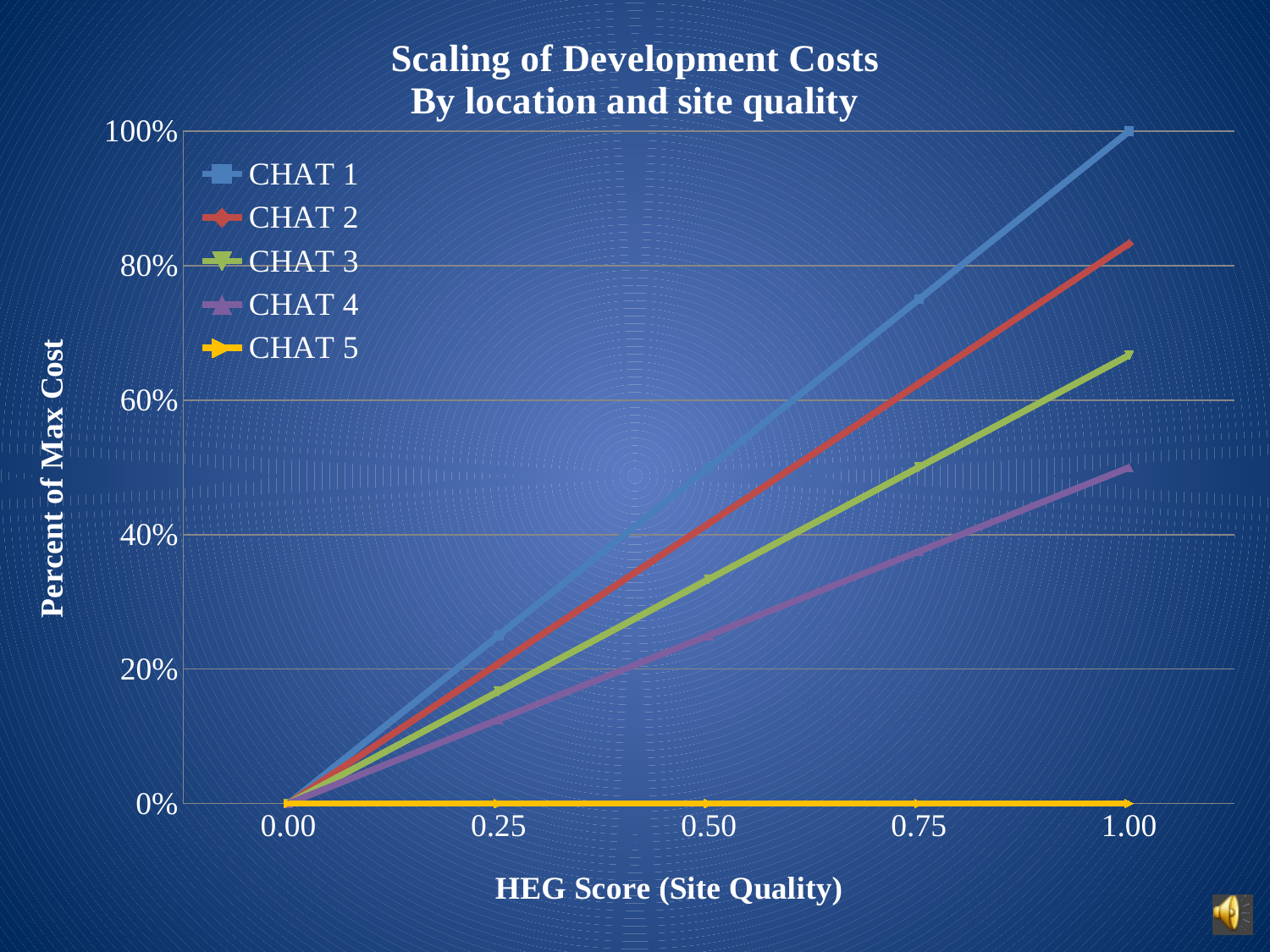
Which series has the highest value at a HEG Score of 1.00? CHAT 1 What is the value for CHAT 1 at a HEG Score of 1.00? 100% Is the value for CHAT 2 at a HEG Score of 1.00 greater or less than 80%? greater What is the title of the chart? Scaling of Development Costs By location and site quality How many series does the legend list? 5 What kind of chart is shown on the slide? line chart Which series has the lowest value at a HEG Score of 1.00? CHAT 5 Does the value for CHAT 1 rise or fall as the HEG Score increases from 0.00 to 1.00? rise Is the value for CHAT 4 at a HEG Score of 1.00 greater or less than 60%? less At a HEG Score of 1.00, which is larger, the value for CHAT 2 or the value for CHAT 4? CHAT 2 What is the value for CHAT 5 at a HEG Score of 1.00? 0% Is the value for CHAT 3 at a HEG Score of 0.50 greater or less than 40%? less